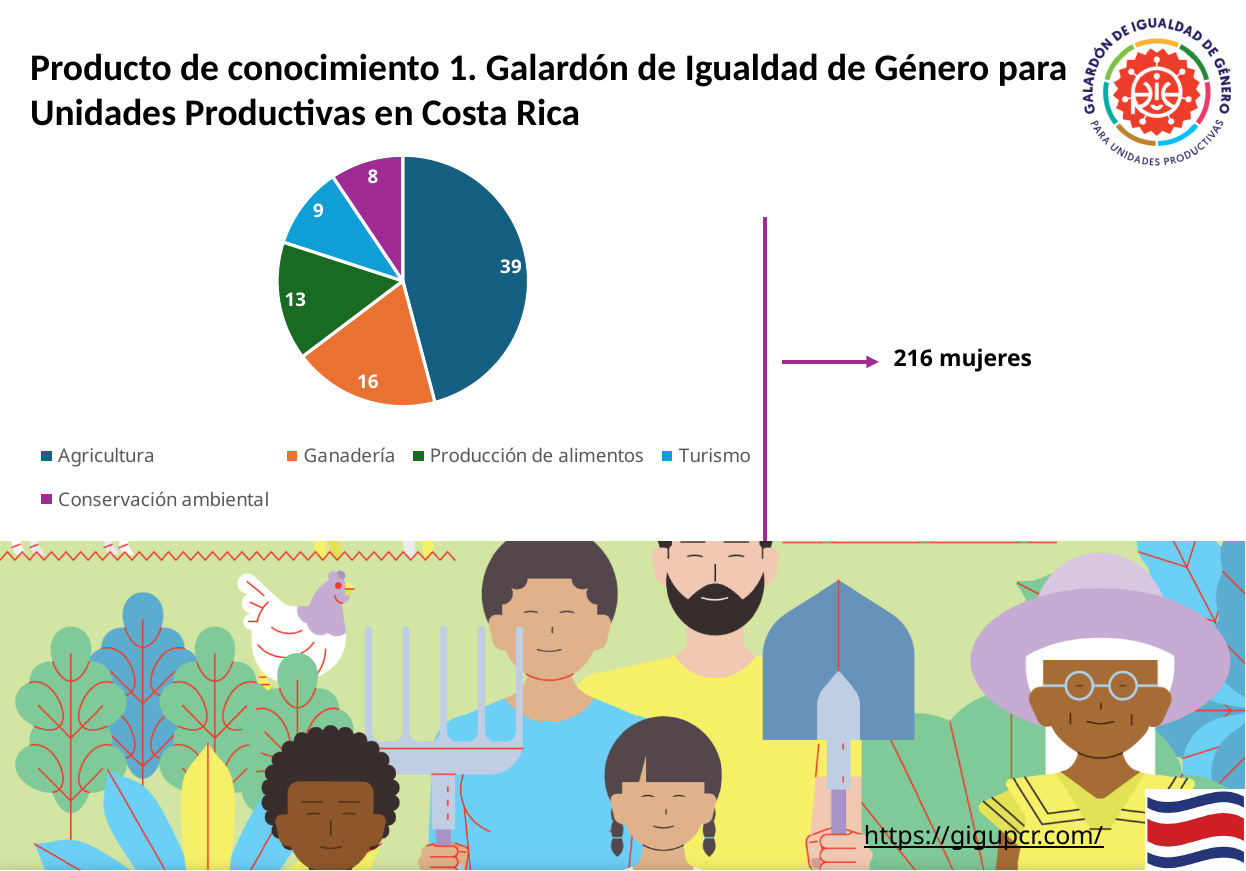
Which category has the smallest slice in the pie chart? Conservación ambiental How many categories does the pie chart have? 5 What is the difference between the values for Agricultura and Ganadería? 23 What is the value for Turismo in the pie chart? 9 What is the sum of all the values shown in the pie chart? 85 What is the value for Agricultura in the pie chart? 39 What is the value for Ganadería in the pie chart? 16 What is the value for Conservación ambiental in the pie chart? 8 Which is larger, the value for Producción de alimentos or the value for Turismo? Producción de alimentos What type of chart is shown on the slide? Pie chart What is the value for Producción de alimentos in the pie chart? 13 Which category has the largest slice in the pie chart? Agricultura